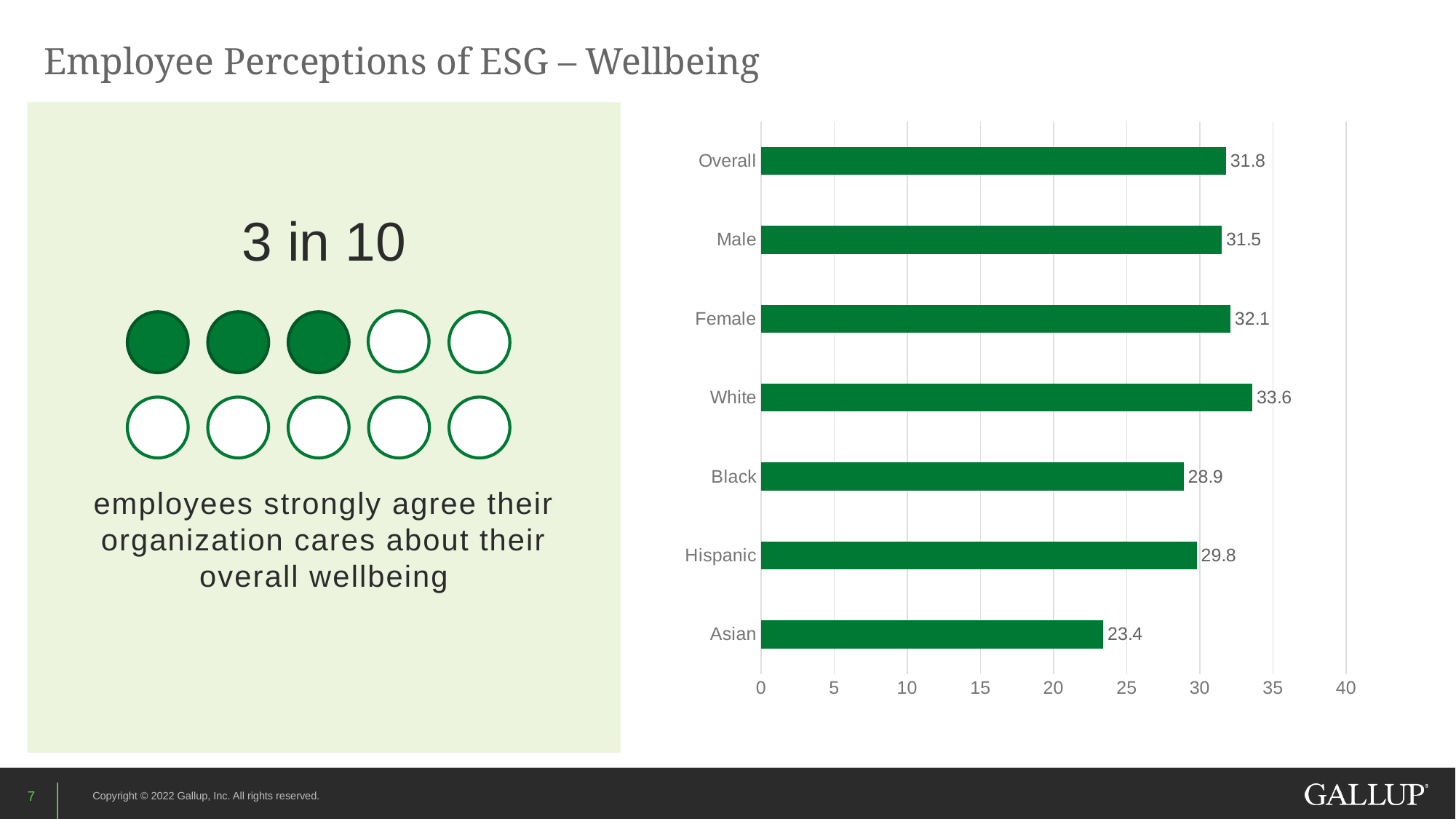
Which category has the lowest value? Asian How many categories are shown in the bar chart? 7 What kind of chart is shown on the slide? bar chart Is the value for Asian greater or less than 25? less Which category has the highest value? White What is the difference between the values for Female and Male? 0.6 What is the difference between the values for White and Asian? 10.2 What is the value for Overall? 31.8 What is the value for Asian? 23.4 What is the value for Hispanic? 29.8 What is the maximum value shown on the x axis of the chart? 40 Which is larger, the value for Black or the value for Hispanic? Hispanic